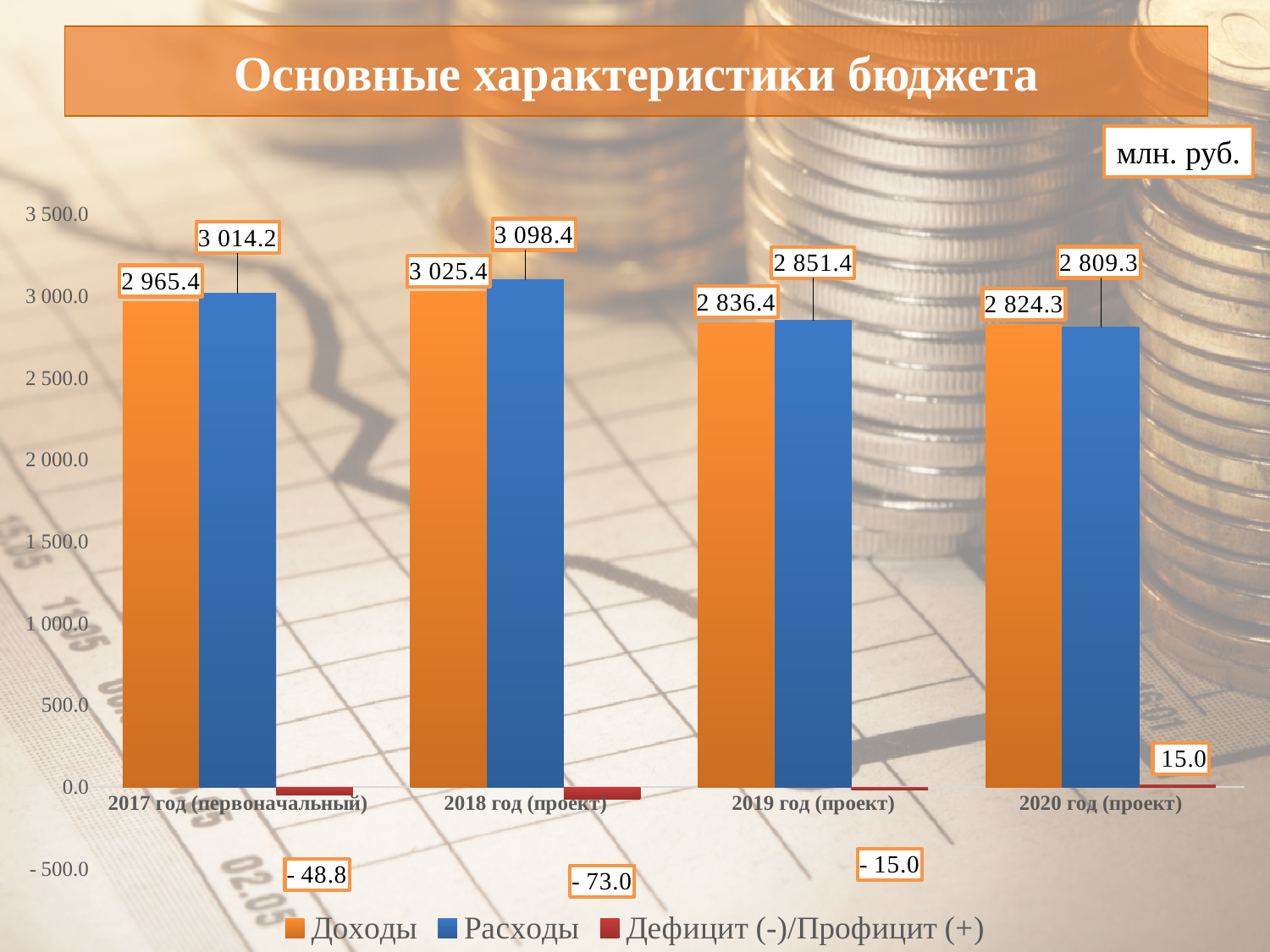
In which year is Доходы lowest? 2020 год (проект) Which is larger for 2020 год (проект): Доходы or Расходы? Доходы What is the value of Расходы for 2017 год (первоначальный)? 3 014.2 In which year is Расходы highest? 2018 год (проект) What is the difference between Расходы and Доходы for 2018 год (проект)? 73.0 How many series does the legend list? 3 How many year categories are shown on the x axis? 4 What kind of chart is shown on the slide? bar chart Is the value of Доходы for 2019 год (проект) greater or less than 3 000.0? less What is the value of Доходы for 2018 год (проект)? 3 025.4 What is the value of Дефицит (-)/Профицит (+) for 2020 год (проект)? 15.0 What is the value of Дефицит (-)/Профицит (+) for 2019 год (проект)? - 15.0